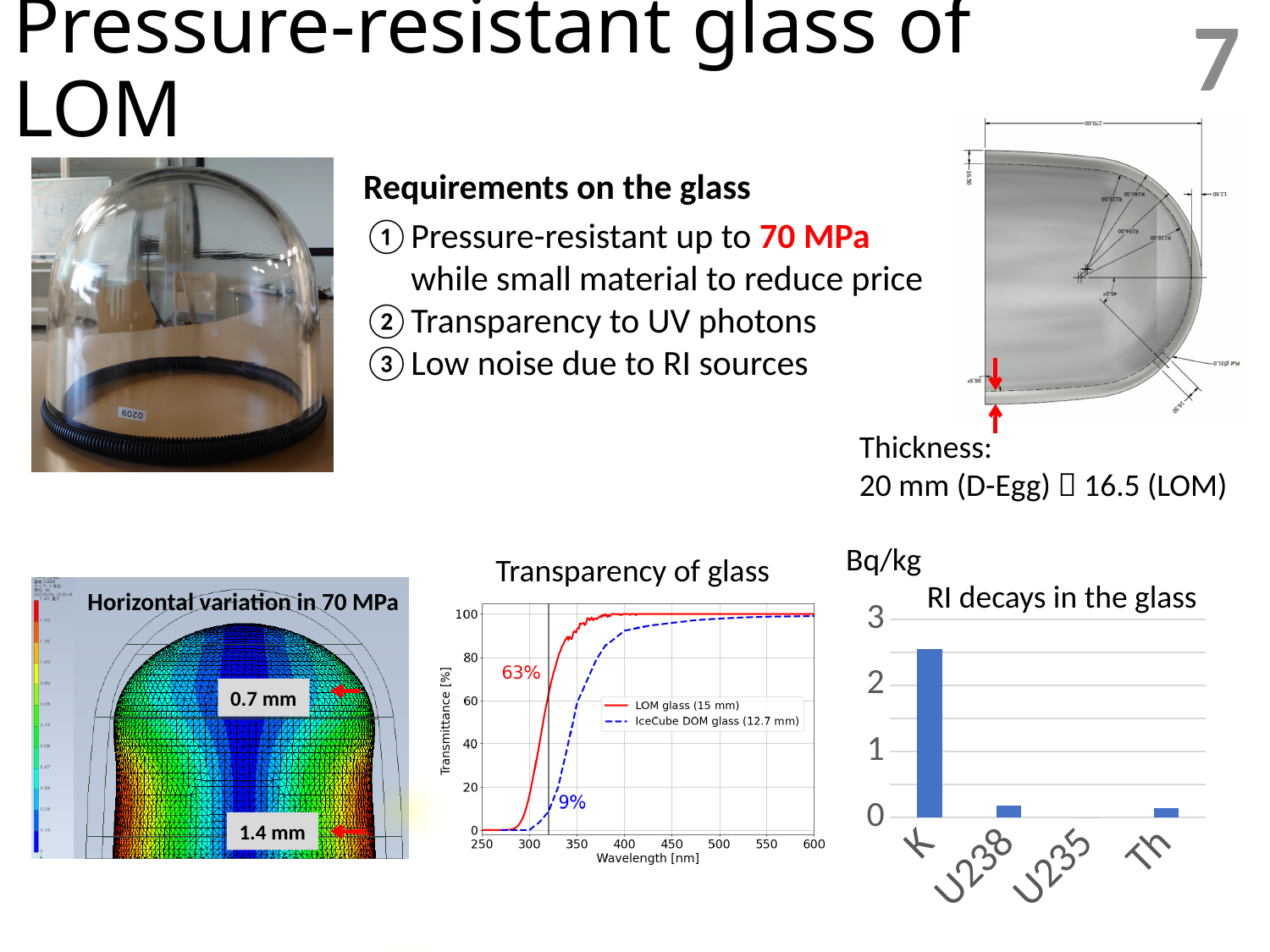
In the 'Transparency of glass' chart, what transmittance is labelled for the LOM glass at the marked vertical line? 63% In the 'RI decays in the glass' chart, is the value for K greater or less than 2? greater In the 'Transparency of glass' chart, does transmittance rise or fall as wavelength increases from 300 nm to 400 nm? rise In the 'Transparency of glass' chart, what transmittance is labelled for the IceCube DOM glass at the marked vertical line? 9% In the 'RI decays in the glass' chart, which is larger, the value for K or the value for Th? K What unit is given for the y axis of the 'RI decays in the glass' chart? Bq/kg In the 'RI decays in the glass' chart, which category has the highest value? K How many series does the legend of the 'Transparency of glass' chart list? 2 How many categories are shown on the x axis of the 'RI decays in the glass' chart? 4 In the 'RI decays in the glass' chart, is the value for U238 greater or less than 1? less What kind of chart is the 'RI decays in the glass' chart? bar chart In the 'RI decays in the glass' chart, which category has the lowest value? U235